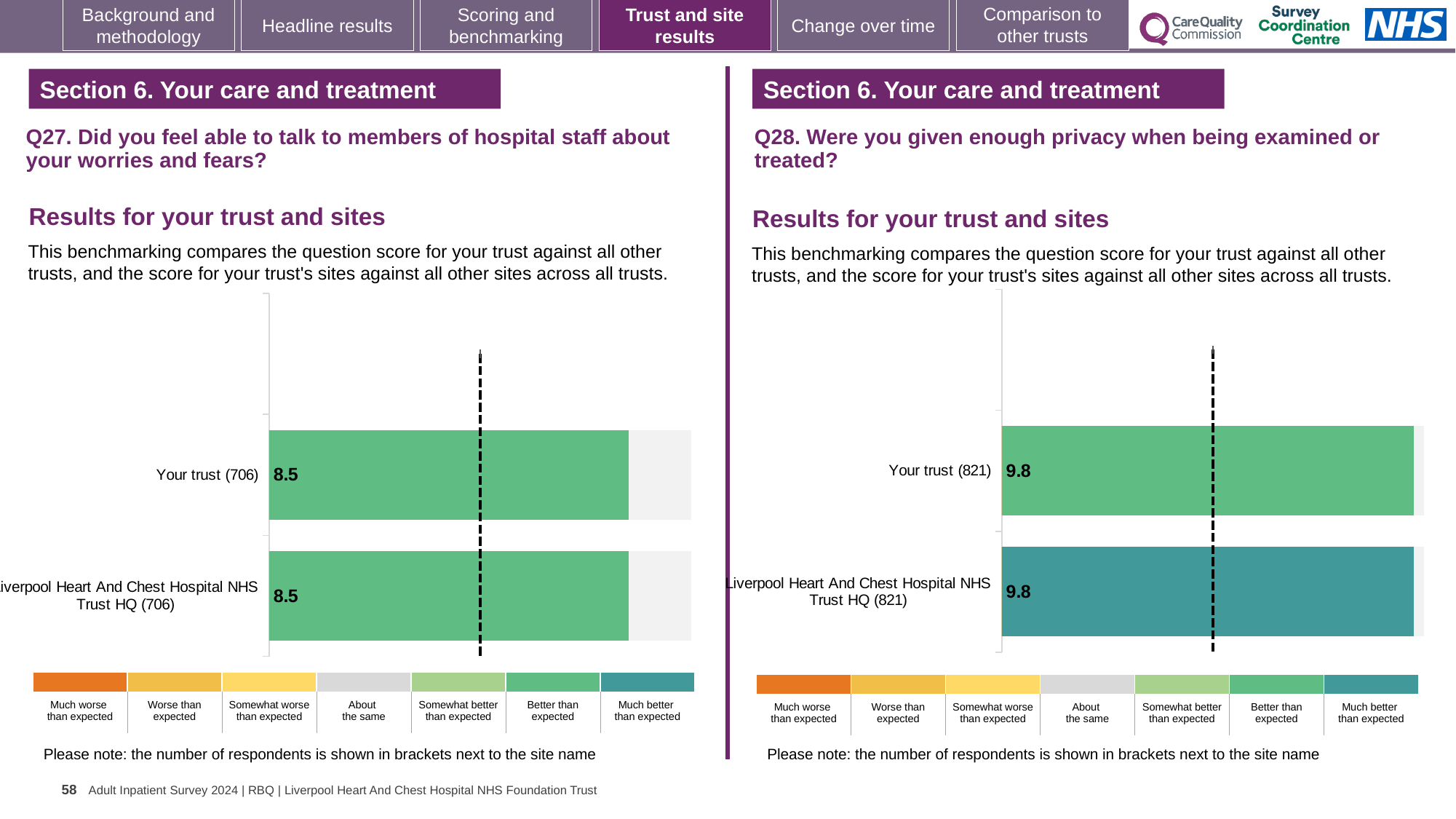
What kind of chart is used for the Q27 results on the left? Bar chart In the Q28 chart on the right, how many respondents are shown in brackets for Liverpool Heart And Chest Hospital NHS Trust HQ? 821 In the Q28 chart on the right, what is the difference between the score for Your trust and the score for Liverpool Heart And Chest Hospital NHS Trust HQ? 0 In the Q27 chart on the left, how many respondents are shown in brackets for Your trust? 706 How many bars are plotted in the Q27 chart on the left? 2 In the Q28 chart on the right, what is the score for Liverpool Heart And Chest Hospital NHS Trust HQ? 9.8 In the Q27 chart on the left, what is the score for Your trust? 8.5 Is the score for Your trust in the Q28 chart on the right larger or smaller than the score for Your trust in the Q27 chart on the left? Larger How many bars are plotted in the Q28 chart on the right? 2 In the Q27 chart on the left, what is the score for Liverpool Heart And Chest Hospital NHS Trust HQ? 8.5 In the Q27 chart on the left, what is the difference between the score for Your trust and the score for Liverpool Heart And Chest Hospital NHS Trust HQ? 0 In the Q28 chart on the right, what is the score for Your trust? 9.8